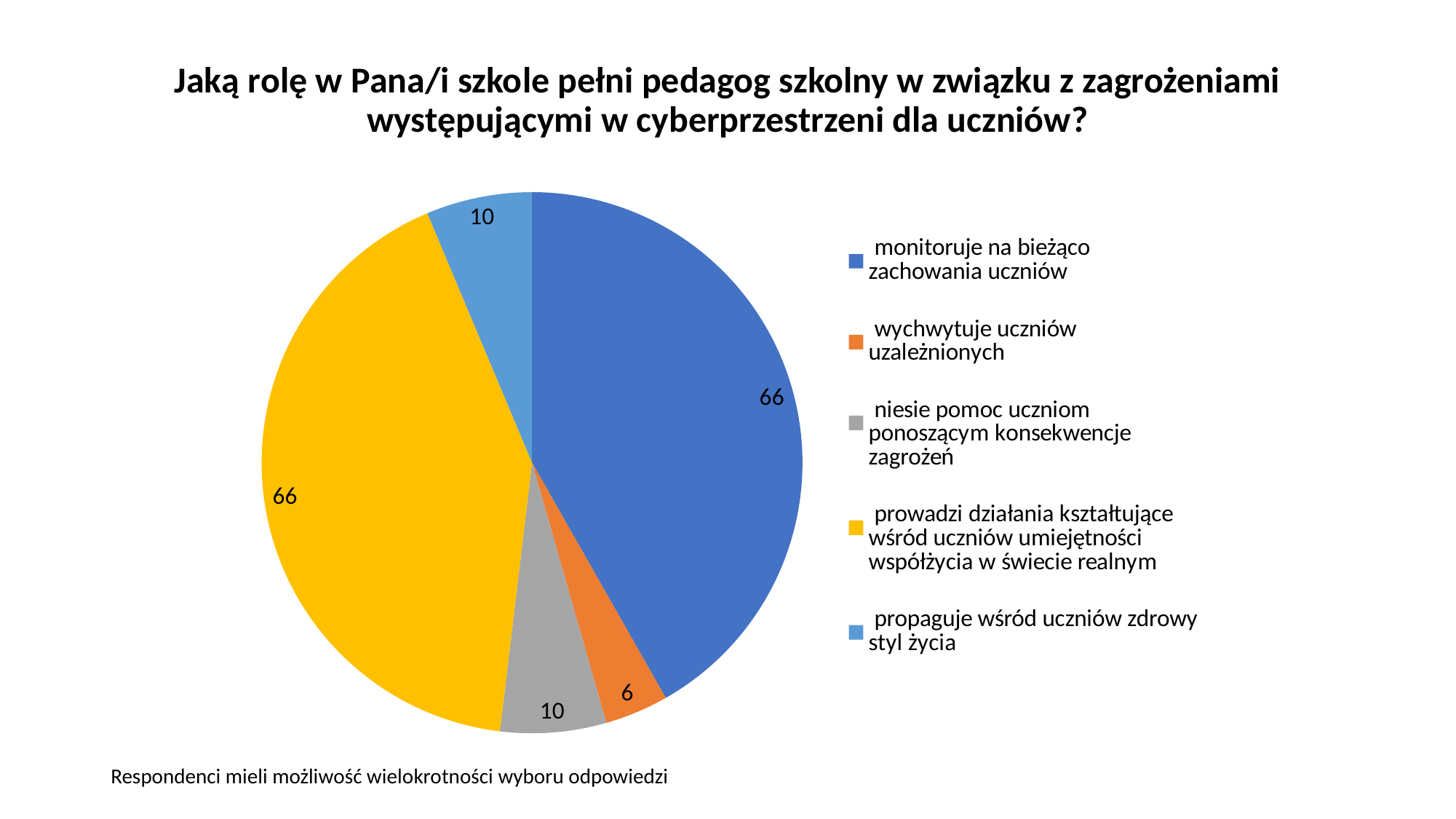
What is the value for "propaguje wśród uczniów zdrowy styl życia"? 10 What is the value for "monitoruje na bieżąco zachowania uczniów"? 66 How many categories does the pie chart have? 5 Which is larger: the value for "niesie pomoc uczniom ponoszącym konsekwencje zagrożeń" or the value for "wychwytuje uczniów uzależnionych"? niesie pomoc uczniom ponoszącym konsekwencje zagrożeń What is the value for "niesie pomoc uczniom ponoszącym konsekwencje zagrożeń"? 10 What is the value for "wychwytuje uczniów uzależnionych"? 6 What kind of chart is shown on the slide? pie chart Which category has the lowest value? wychwytuje uczniów uzależnionych What is the value for "prowadzi działania kształtujące wśród uczniów umiejętności współżycia w świecie realnym"? 66 What is the total of all the values shown in the pie chart? 158 What is the difference between the value for "monitoruje na bieżąco zachowania uczniów" and the value for "wychwytuje uczniów uzależnionych"? 60 What colour is the slice for "propaguje wśród uczniów zdrowy styl życia"? light blue